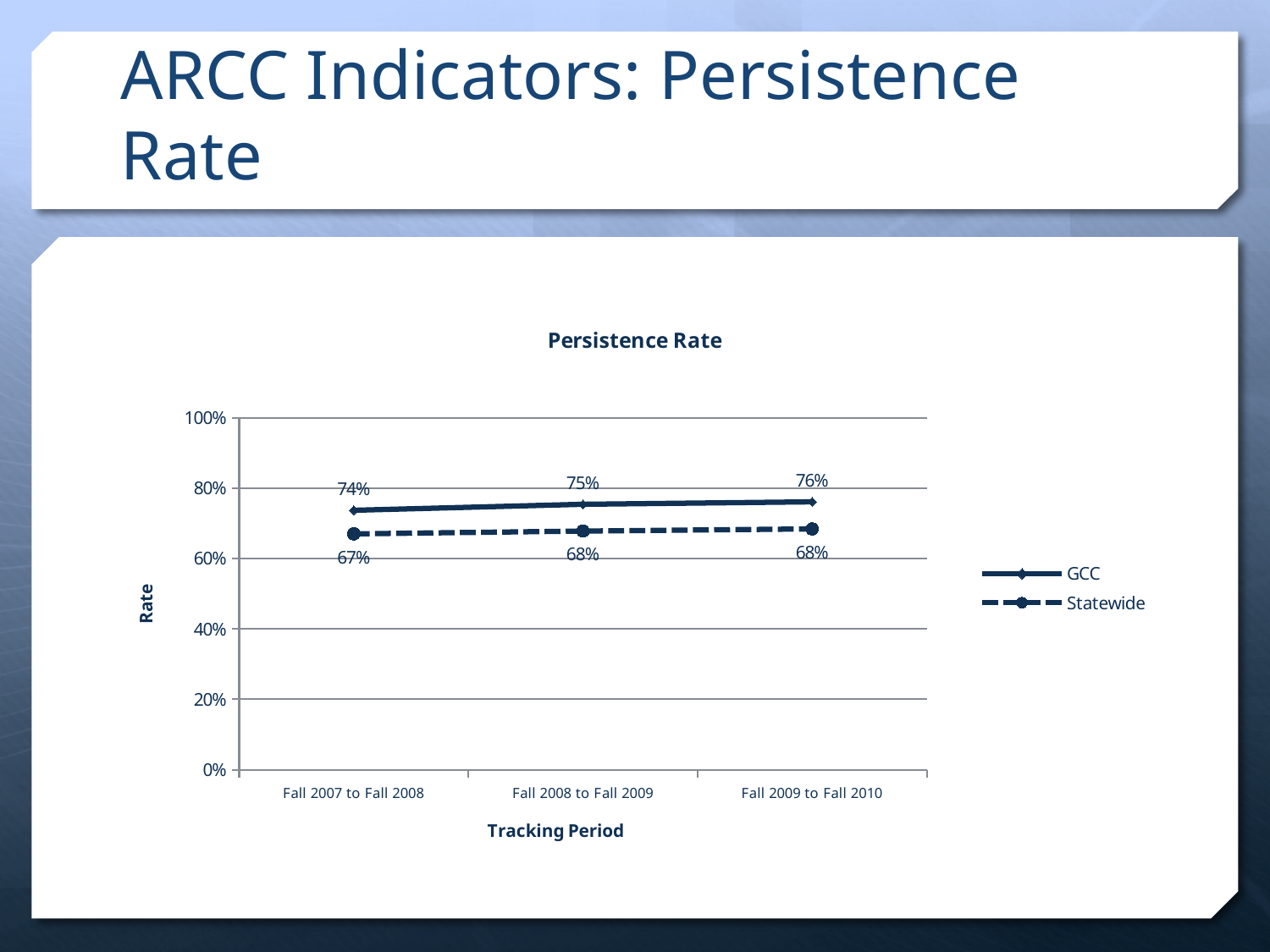
What is the difference between the GCC and Statewide persistence rates for Fall 2009 to Fall 2010? 8% In which tracking period is the GCC persistence rate highest? Fall 2009 to Fall 2010 What is the GCC persistence rate for Fall 2008 to Fall 2009? 75% What kind of chart is shown on the slide? Line chart What is the Statewide persistence rate for Fall 2009 to Fall 2010? 68% Does the GCC persistence rate rise or fall across the tracking periods? Rise How many tracking periods are shown on the x axis? 3 Which series has the higher persistence rate for Fall 2008 to Fall 2009, GCC or Statewide? GCC What is the Statewide persistence rate for Fall 2007 to Fall 2008? 67% In which tracking period is the Statewide persistence rate lowest? Fall 2007 to Fall 2008 What is the GCC persistence rate for Fall 2007 to Fall 2008? 74% How many series does the legend list? 2